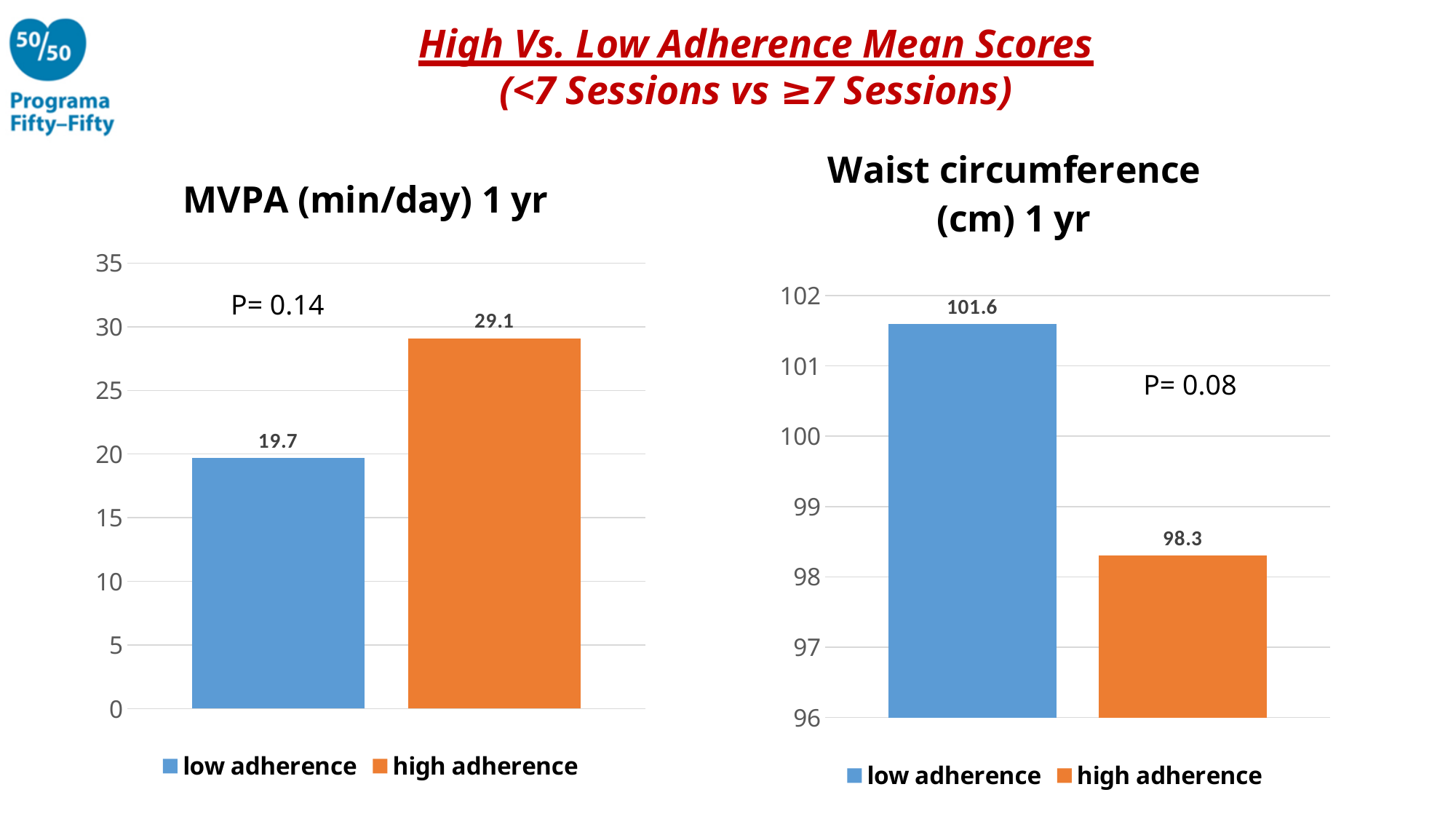
In the MVPA (min/day) 1 yr chart, what is the value for high adherence? 29.1 In the MVPA (min/day) 1 yr chart, what is the value for low adherence? 19.7 In the Waist circumference (cm) 1 yr chart, which group has the lower value? high adherence In the Waist circumference (cm) 1 yr chart, what is the difference between the low adherence and high adherence values? 3.3 In the MVPA (min/day) 1 yr chart, what is the difference between the high adherence and low adherence values? 9.4 In the Waist circumference (cm) 1 yr chart, what is the value for low adherence? 101.6 In the Waist circumference (cm) 1 yr chart, what is the value for high adherence? 98.3 In the Waist circumference (cm) 1 yr chart, what P value is shown? P= 0.08 How many series does the legend of the Waist circumference (cm) 1 yr chart list? 2 What kind of chart is the MVPA (min/day) 1 yr chart? bar chart In the MVPA (min/day) 1 yr chart, is the value for low adherence greater or less than 20? less In the MVPA (min/day) 1 yr chart, which group has the higher value? high adherence